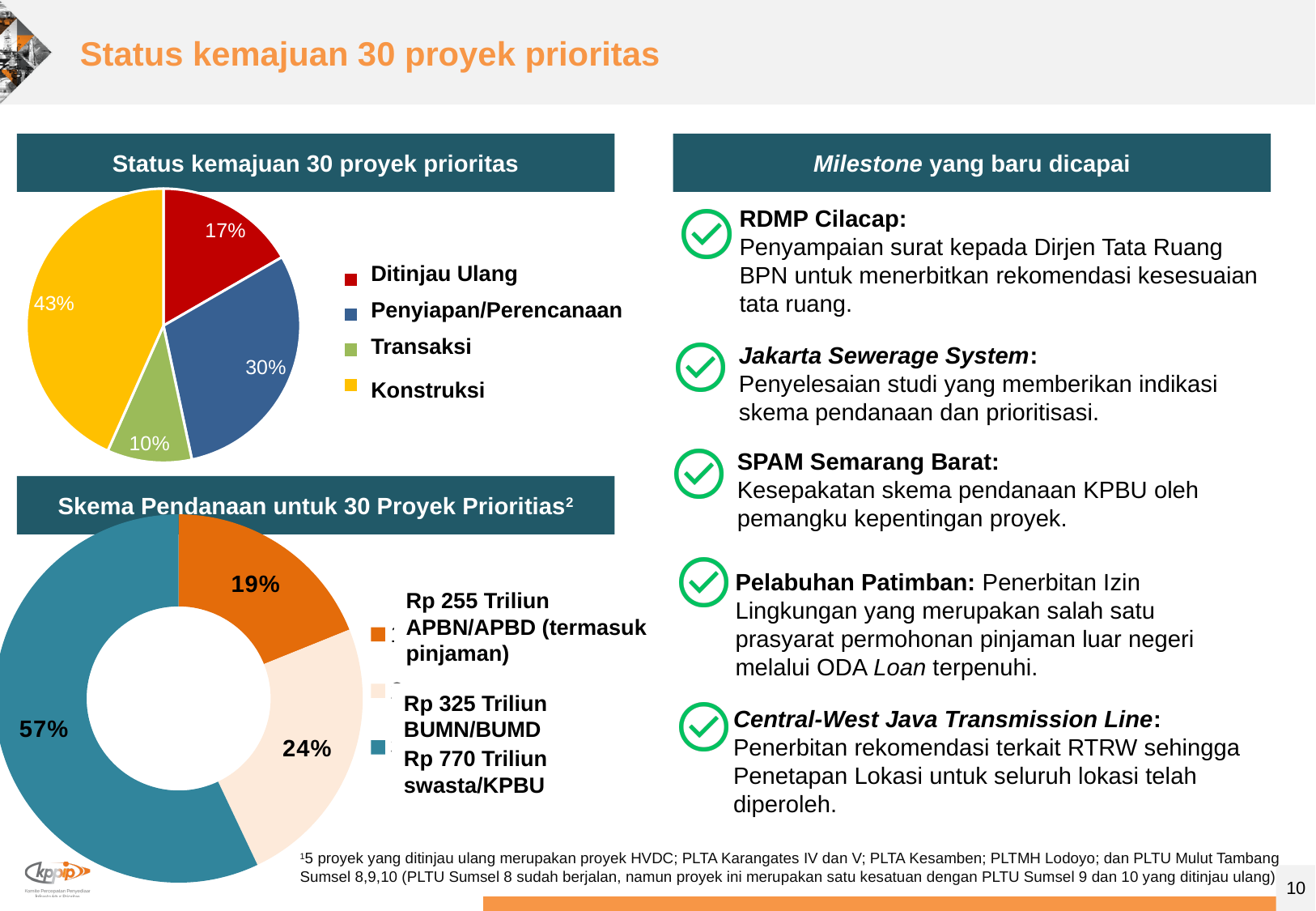
In the 'Status kemajuan 30 proyek prioritas' pie chart, how many categories are shown? 4 In the 'Status kemajuan 30 proyek prioritas' pie chart, what colour is the Ditinjau Ulang slice? Red In the 'Status kemajuan 30 proyek prioritas' pie chart, what percentage is shown for Konstruksi? 43% In the 'Status kemajuan 30 proyek prioritas' pie chart, which category has the largest share? Konstruksi In the 'Skema Pendanaan untuk 30 Proyek Prioritias' chart, what percentage is shown for Rp 255 Triliun APBN/APBD (termasuk pinjaman)? 19% In the 'Status kemajuan 30 proyek prioritas' pie chart, what percentage is shown for Transaksi? 10% What type of chart is 'Status kemajuan 30 proyek prioritas'? Pie chart In the 'Skema Pendanaan untuk 30 Proyek Prioritias' chart, which is larger: the share for BUMN/BUMD or the share for APBN/APBD? BUMN/BUMD In the 'Skema Pendanaan untuk 30 Proyek Prioritias' chart, what percentage is shown for Rp 770 Triliun swasta/KPBU? 57% In the 'Skema Pendanaan untuk 30 Proyek Prioritias' chart, how many funding categories are shown? 3 In the 'Status kemajuan 30 proyek prioritas' pie chart, what is the difference in percentage points between Penyiapan/Perencanaan and Ditinjau Ulang? 13 In the 'Status kemajuan 30 proyek prioritas' pie chart, which category has the smallest share? Transaksi